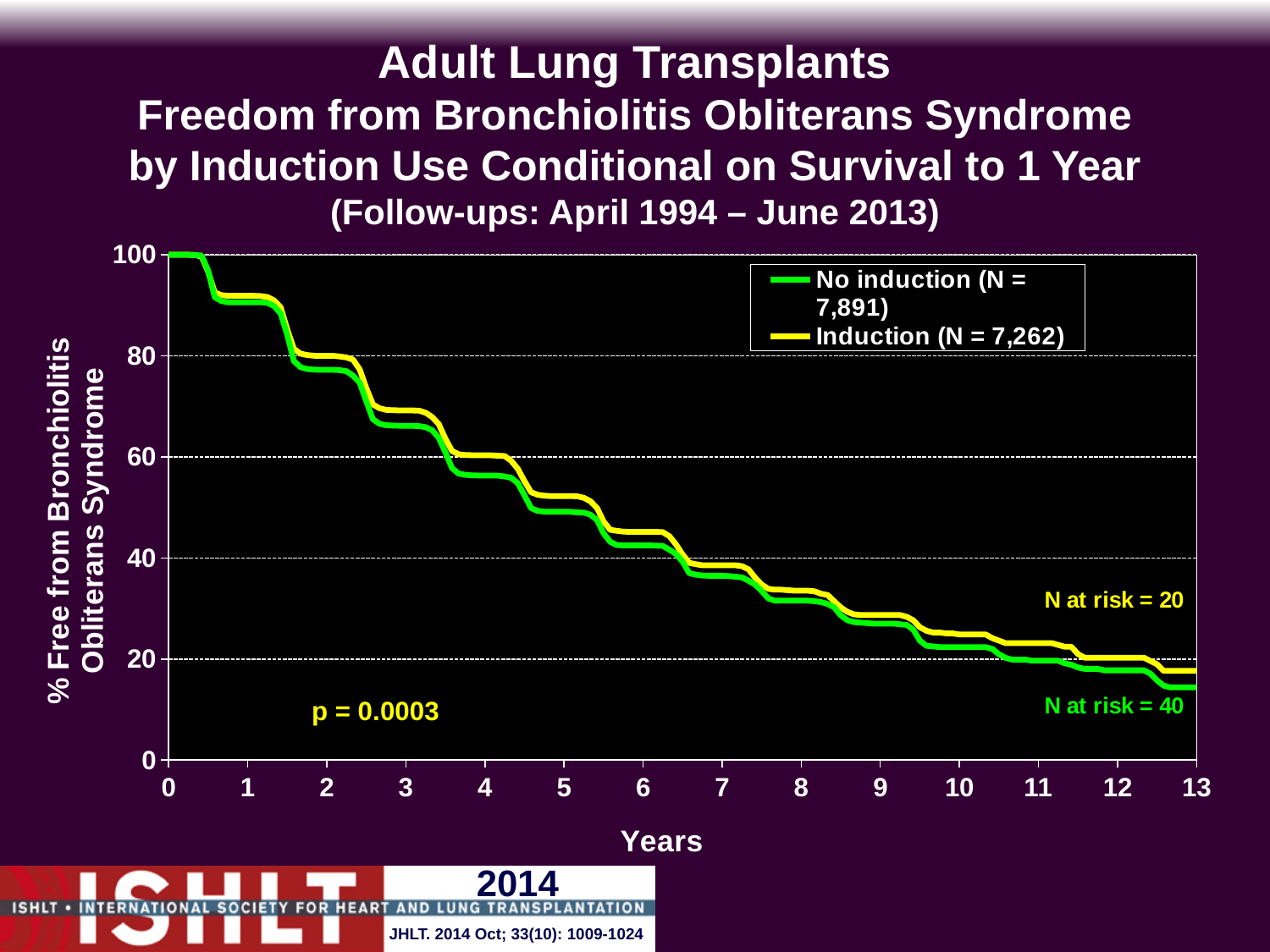
Do the values for the Induction series rise or fall as years increase? fall Is the value for the No induction series at year 3 greater or less than 60? greater Is the value for the Induction series at year 5 greater or less than 40? greater At year 3, which series has the lower value, Induction or No induction? No induction At year 5, which series has the higher value, Induction or No induction? Induction How many series does the legend list? 2 Is the value for the Induction series at year 8 greater or less than 40? less What p-value is printed on the chart? p = 0.0003 Do the values for the No induction series rise or fall along the x axis? fall What kind of chart is shown on the slide? line chart What is the N shown in the legend for the No induction series? 7,891